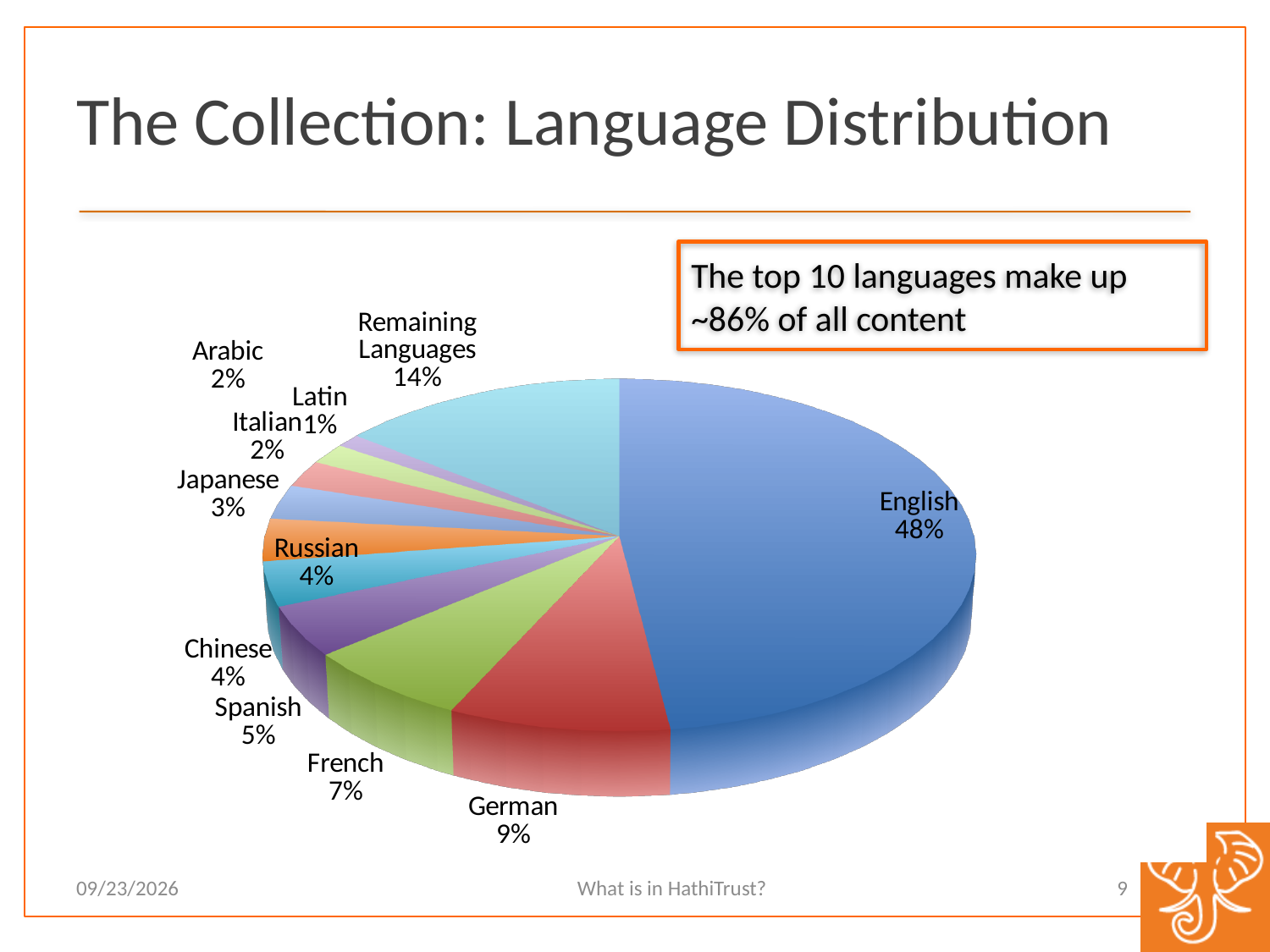
What is the title of the slide containing the chart? The Collection: Language Distribution Which language has the smallest slice of the pie? Latin What share of the collection is labelled Remaining Languages? 14% What is the difference in percentage points between English and German? 39 What share of the collection is French? 7% What share of the collection is English? 48% What share of the collection is German? 9% What share of the collection is Latin? 1% How many slices does the pie chart have? 11 What kind of chart is shown on the slide? pie chart Which language has the largest slice of the pie? English Which is larger, the share for Spanish or the share for Japanese? Spanish